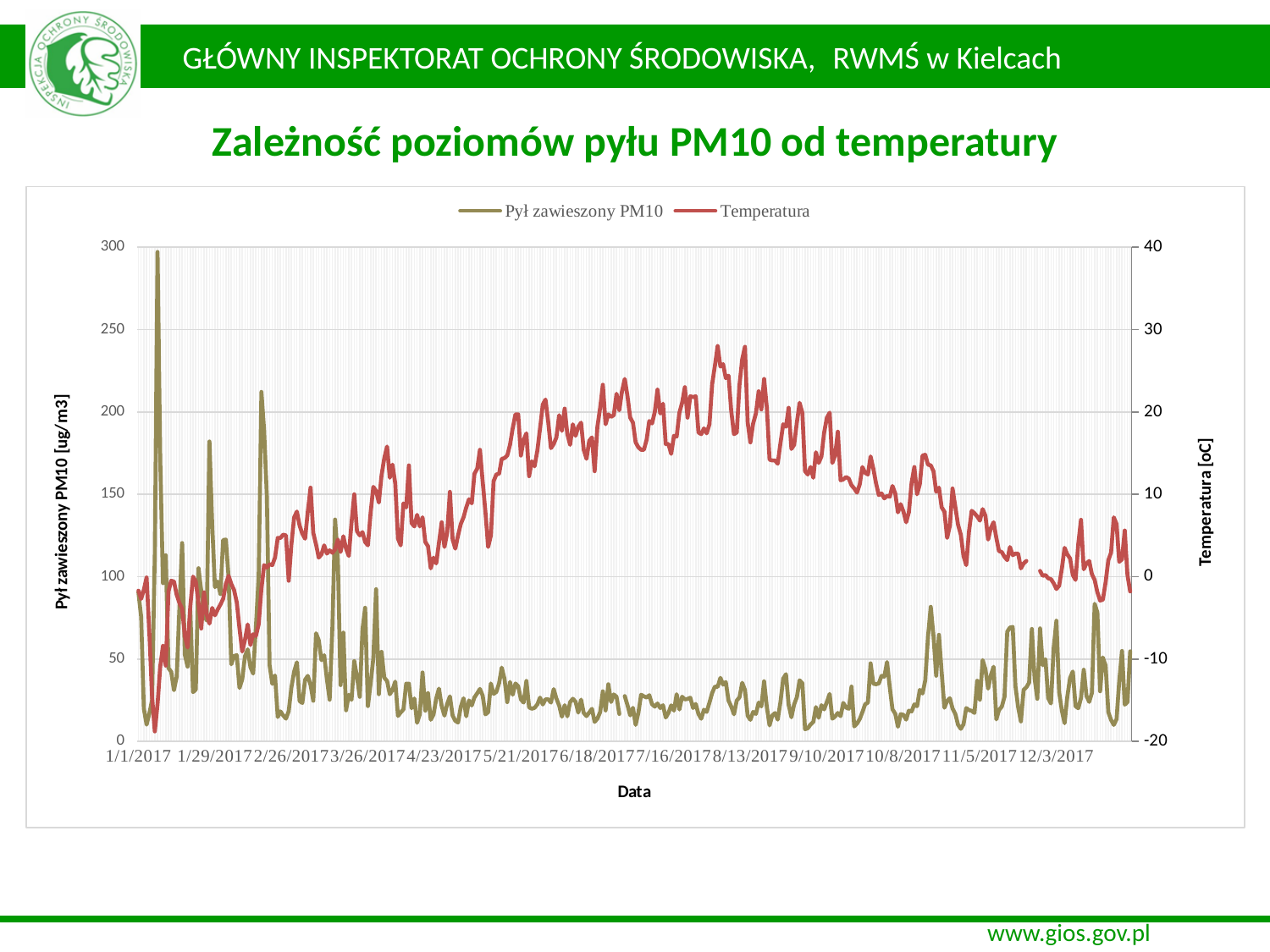
What kind of chart is shown on the slide? line chart What is the title of the left vertical axis? Pył zawieszony PM10 [ug/m3] Is the lowest value of the Temperatura series (in early January 2017) greater or less than -10 on the right axis? less Is the Pył zawieszony PM10 peak in late February 2017 greater or less than 200? greater How many series does the legend list? 2 What are the two series named in the legend? Pył zawieszony PM10 and Temperatura Does the Temperatura series generally rise or fall from January 2017 to August 2017? rise Are the Pył zawieszony PM10 values in July 2017 greater or less than 50? less Does the Temperatura series generally rise or fall from August 2017 to December 2017? fall In which month does the Pył zawieszony PM10 series reach its highest peak? January 2017